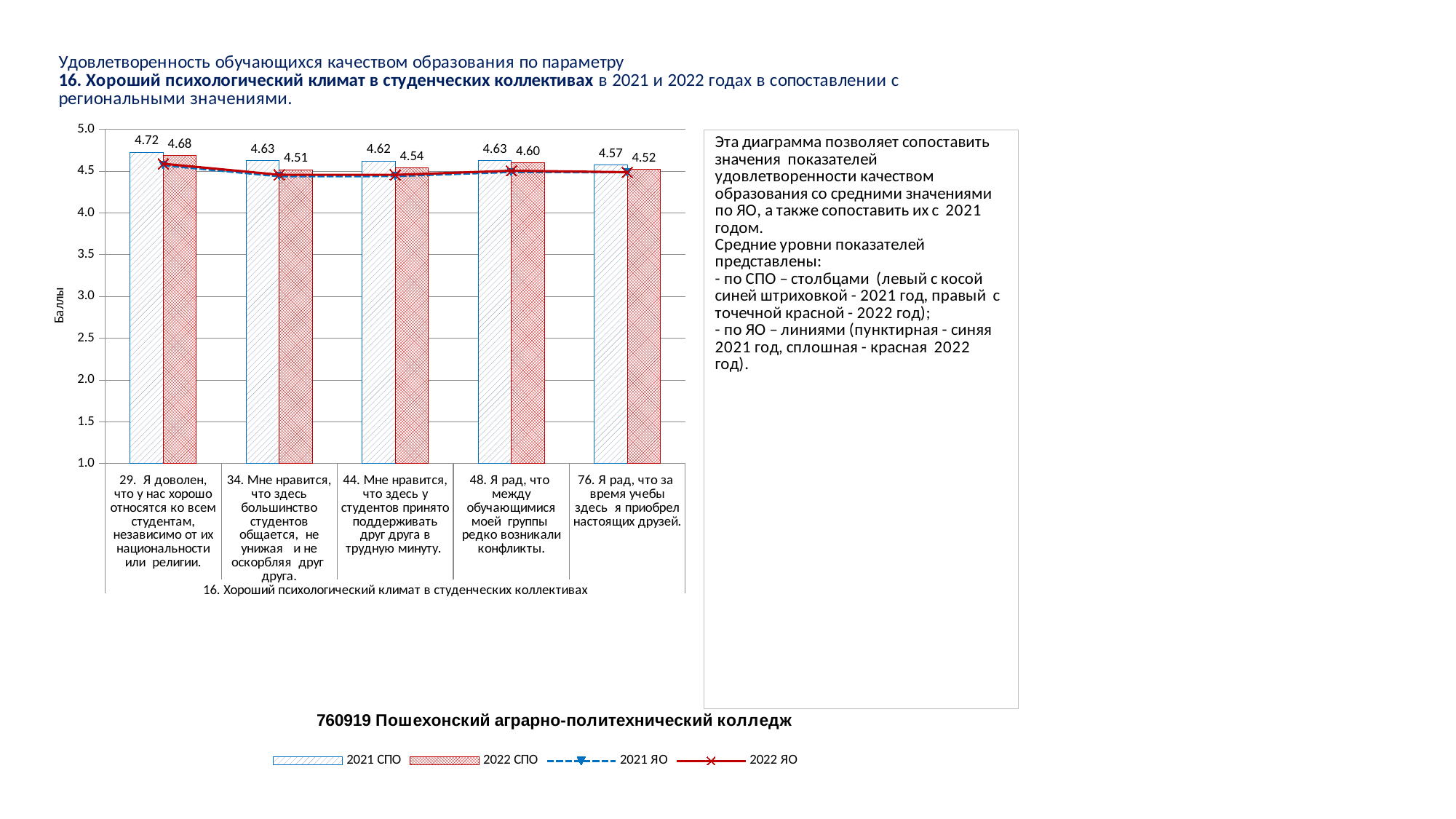
How many categories are shown on the x axis of the chart? 5 What is the difference between the 2021 СПО and 2022 СПО values for category 34? 0.12 What kind of chart is shown on the slide? Combined bar and line chart Which category has the lowest 2022 СПО value? 34. Мне нравится, что здесь большинство студентов общается, не унижая и не оскорбляя друг друга. For category 44, which is larger: the 2021 СПО value or the 2022 СПО value? 2021 СПО How many series does the chart legend list? 4 What is the 2022 СПО value for category 48 (Я рад, что между обучающимися моей группы редко возникали конфликты)? 4.60 What is the label of the vertical axis of the chart? Баллы What is the 2021 СПО value for category 29 (Я доволен, что у нас хорошо относятся ко всем студентам...)? 4.72 Is the 2022 ЯО value for category 29 greater or less than 4.0? greater Which category has the highest 2021 СПО value? 29. Я доволен, что у нас хорошо относятся ко всем студентам, независимо от их национальности или религии. What is the 2022 СПО value for category 76 (Я рад, что за время учебы здесь я приобрел настоящих друзей)? 4.52